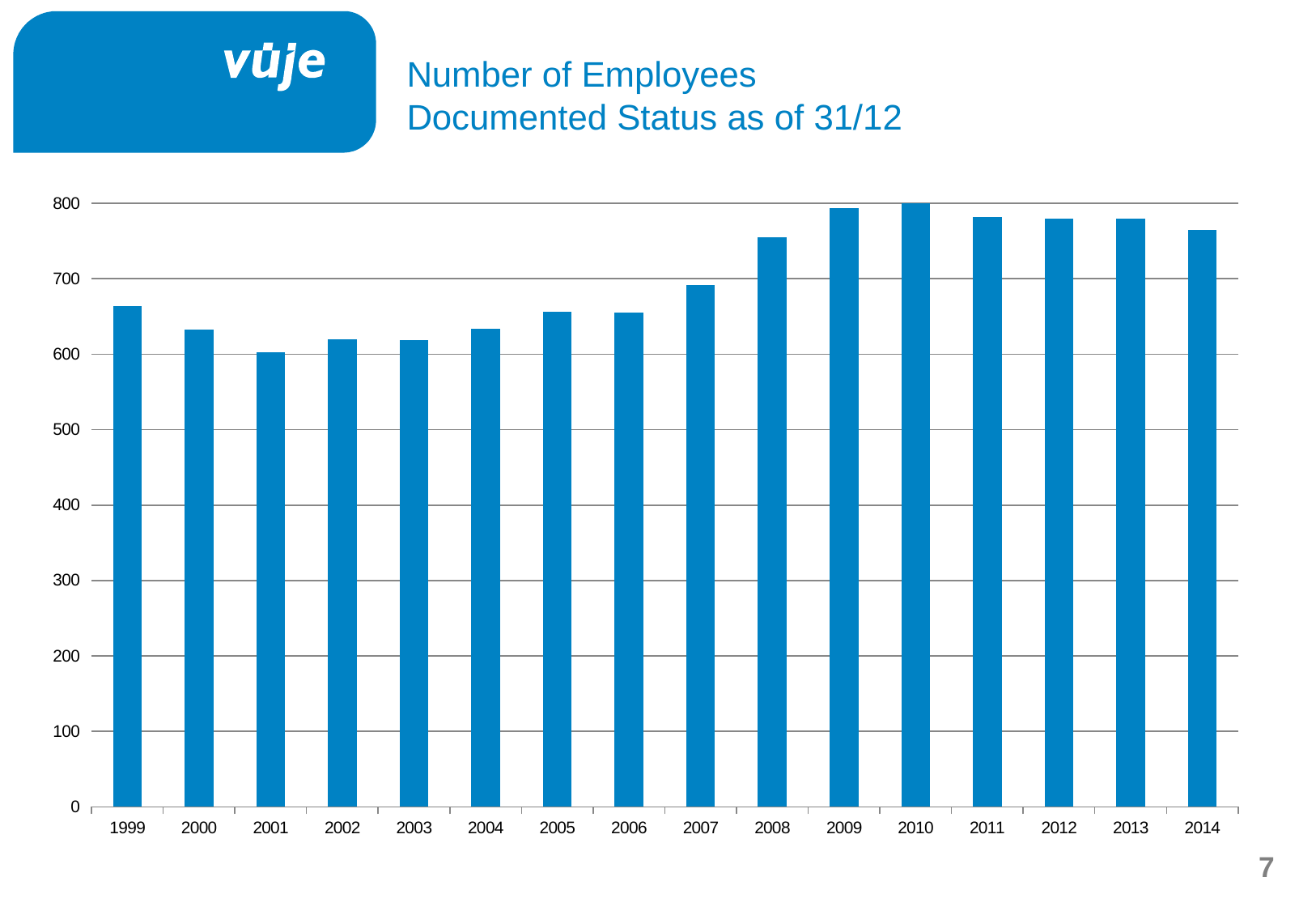
Is the value for 1999 greater or less than 700? less Which is larger, the value for 2007 or the value for 2008? 2008 How many years are shown on the x axis of the chart? 16 Is the value for 2014 greater or less than 700? greater Which year has the lowest number of employees? 2001 Is the value for 2004 greater or less than 600? greater Which is larger, the value for 1999 or the value for 2000? 1999 Do the values rise or fall from 2010 to 2014? fall What is the title of the chart on the slide? Number of Employees Documented Status as of 31/12 What kind of chart is shown on the slide? Bar chart